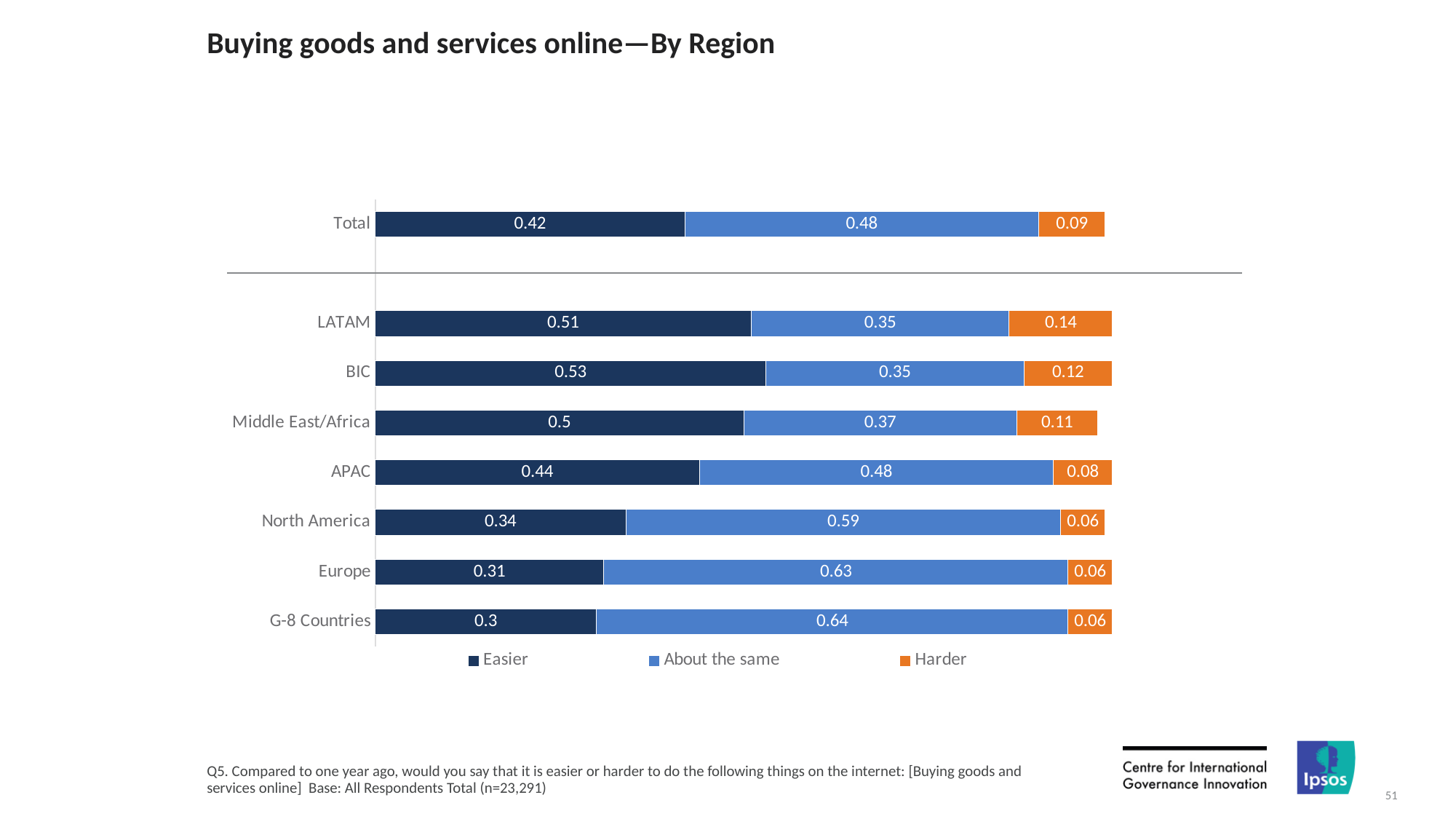
Which region has the highest 'Easier' value? BIC Which region has the highest 'Harder' value? LATAM Which is larger, the 'Easier' value for APAC or for North America? APAC What is the title of the chart? Buying goods and services online—By Region What is the 'Harder' value for Total? 0.09 Which region has the lowest 'Easier' value? G-8 Countries How many regions are shown below the Total bar? 7 How many series does the legend list? 3 What is the 'Easier' value for LATAM? 0.51 What is the 'About the same' value for Europe? 0.63 What kind of chart is shown on the slide? Stacked bar chart What is the difference between the 'About the same' values for G-8 Countries and LATAM? 0.29